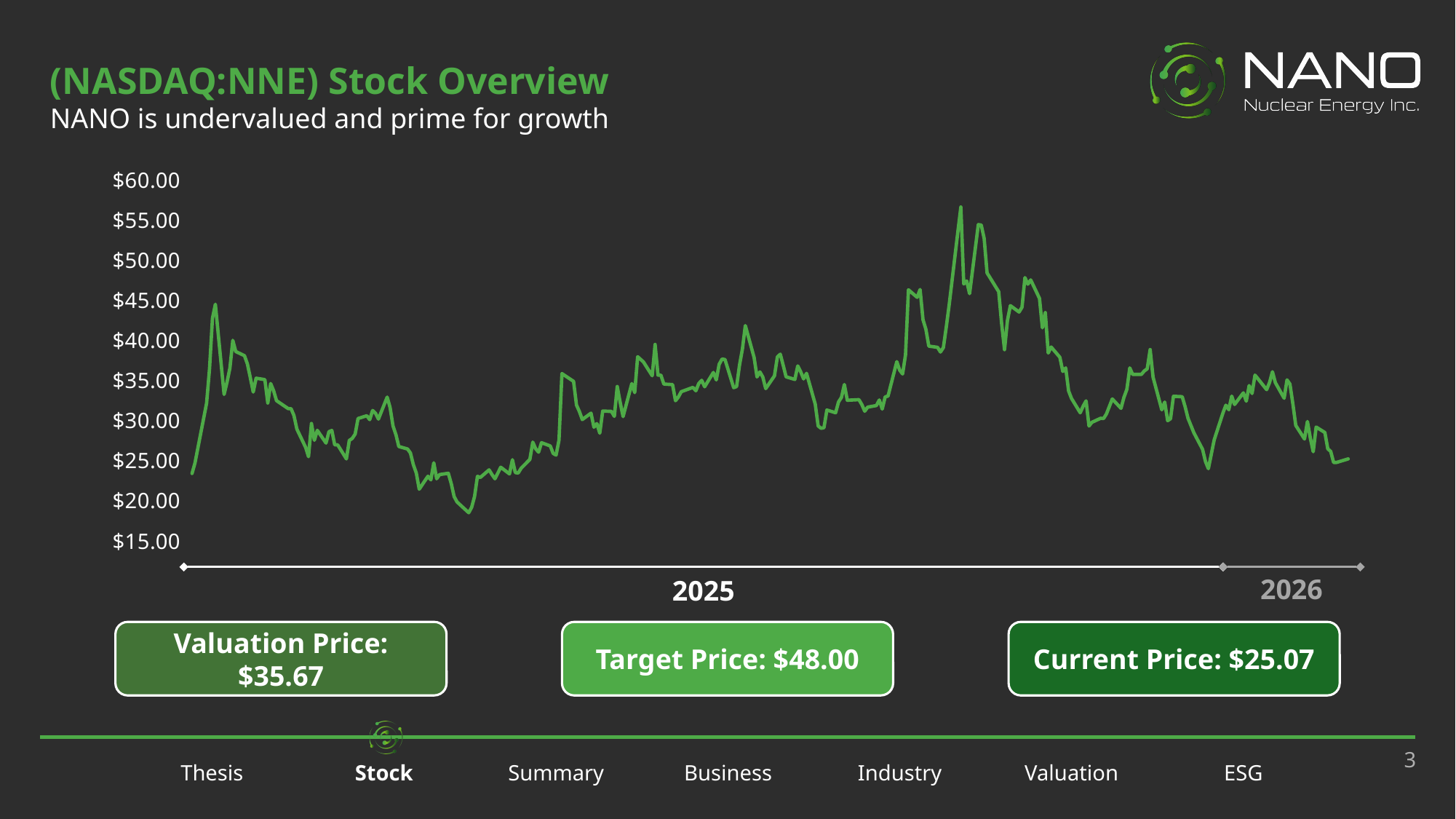
Is the highest point of the stock price line greater or less than $55.00? greater What is the difference between the Target Price and the Current Price shown below the chart? $22.93 What is the Target Price shown below the chart? $48.00 Which is larger, the Target Price or the Valuation Price? Target Price What is the Current Price shown below the chart? $25.07 Is the lowest point of the stock price line greater or less than $20.00? less Does the stock price rise or fall from its late-2025 peak to the end of the line in 2026? fall What is the Valuation Price shown below the chart? $35.67 What is the highest value shown on the y axis? $60.00 Which two years are labelled on the x axis? 2025 and 2026 What kind of chart is shown on the slide? line chart Is the stock price at the start of the line greater or less than $30.00? less